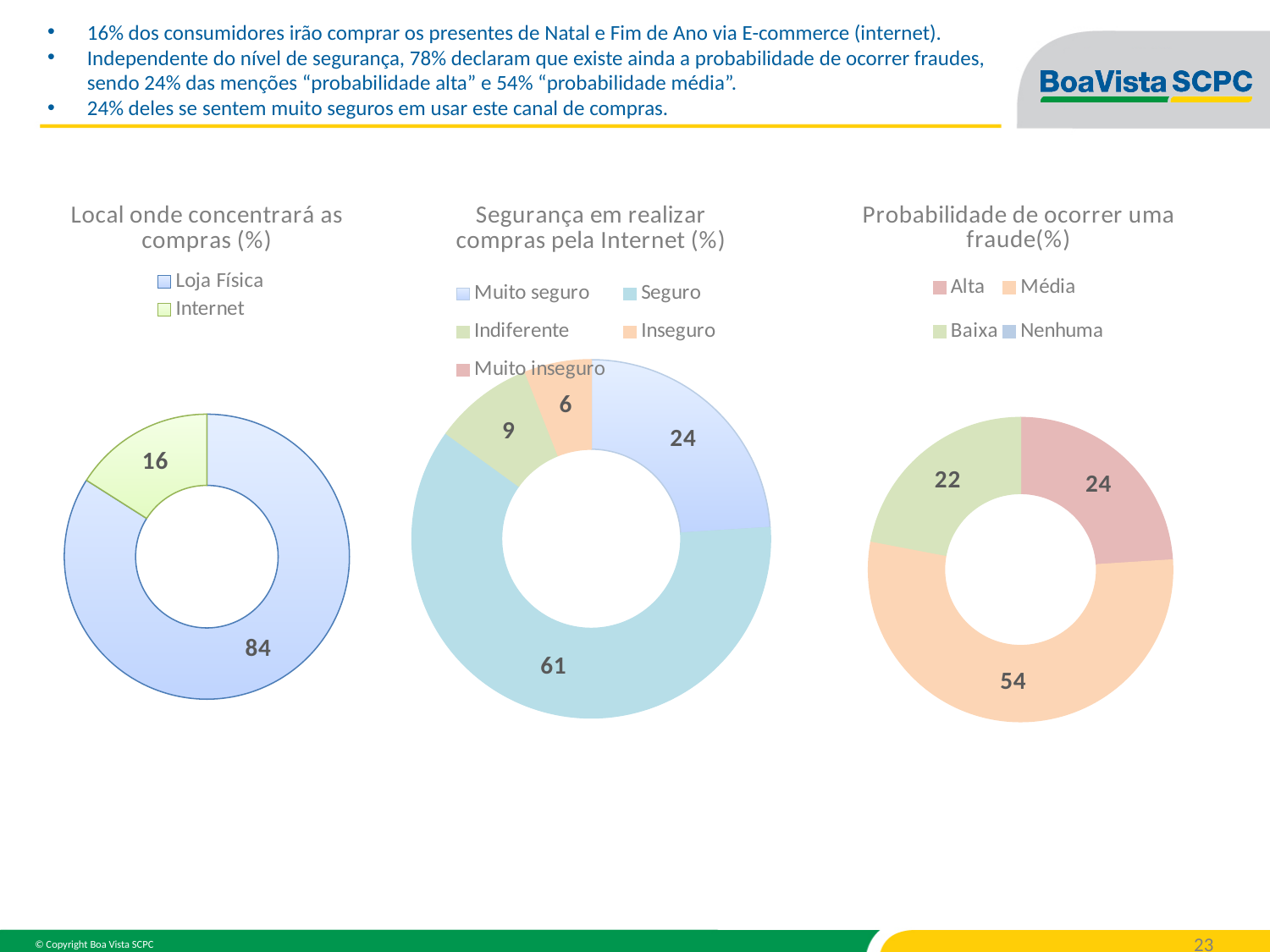
In the chart 'Probabilidade de ocorrer uma fraude(%)', how many entries does the legend list? 4 In the chart 'Probabilidade de ocorrer uma fraude(%)', what is the value for Média? 54 In the chart 'Probabilidade de ocorrer uma fraude(%)', which is larger, Alta or Baixa? Alta What kind of chart is 'Probabilidade de ocorrer uma fraude(%)'? Doughnut chart In the chart 'Local onde concentrará as compras (%)', what is the difference between Loja Física and Internet? 68 In the chart 'Segurança em realizar compras pela Internet (%)', what is the value for Inseguro? 6 In the chart 'Segurança em realizar compras pela Internet (%)', which category has the highest value? Seguro In the chart 'Probabilidade de ocorrer uma fraude(%)', what is the difference between Média and Alta? 30 In the chart 'Segurança em realizar compras pela Internet (%)', how many entries does the legend list? 5 In the chart 'Local onde concentrará as compras (%)', what is the value for Internet? 16 In the chart 'Local onde concentrará as compras (%)', what is the value for Loja Física? 84 In the chart 'Segurança em realizar compras pela Internet (%)', what is the value for Seguro? 61